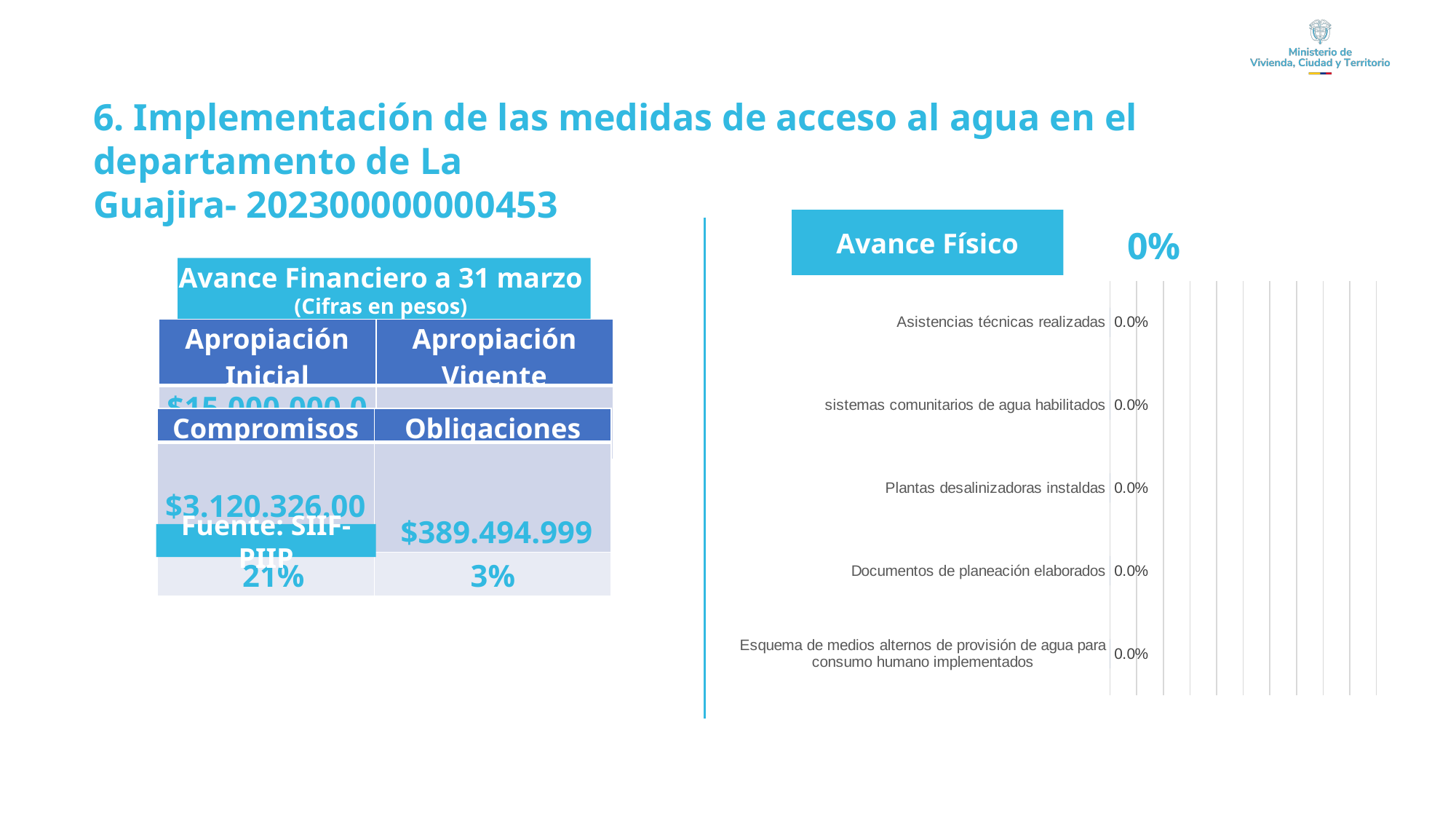
What is the value for Documentos de planeación elaborados in the Avance Físico chart? 0.0% What is the difference between the values for Asistencias técnicas realizadas and Documentos de planeación elaborados in the Avance Físico chart? 0.0% What overall percentage is displayed next to the Avance Físico chart title? 0% What is the value for Esquema de medios alternos de provisión de agua para consumo humano implementados in the Avance Físico chart? 0.0% What is the value for Asistencias técnicas realizadas in the Avance Físico chart? 0.0% What kind of chart is the Avance Físico chart? bar chart What is the value for Plantas desalinizadoras instaldas in the Avance Físico chart? 0.0% What is the value for sistemas comunitarios de agua habilitados in the Avance Físico chart? 0.0% How many categories are shown in the Avance Físico chart? 5 What is the title of the chart on the right side of the slide? Avance Físico